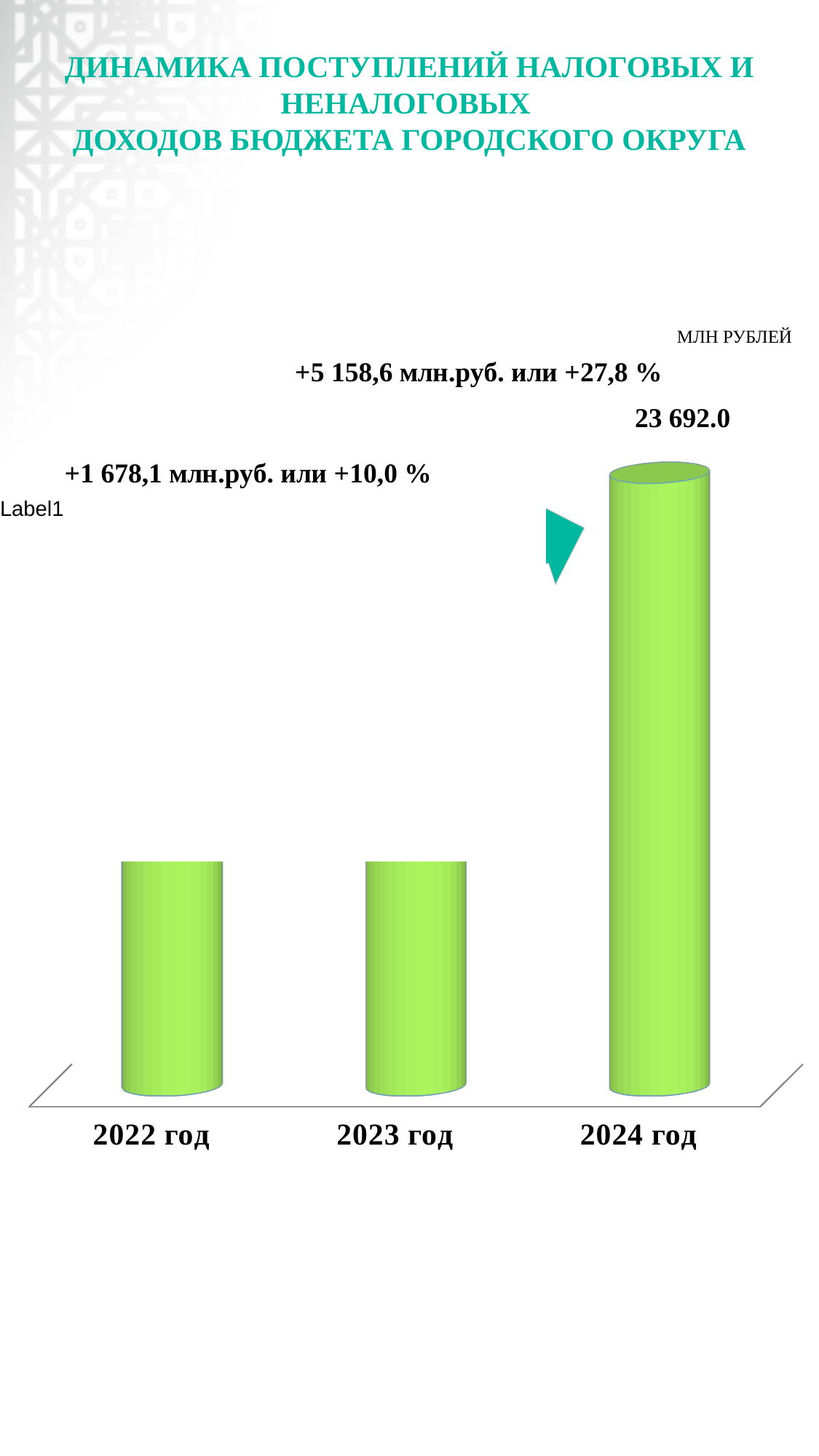
Which is larger, the value for 2024 год or the value for 2022 год? 2024 год Which is larger, the value for 2023 год or the value for 2024 год? 2024 год Do the values rise or fall from 2022 год to 2024 год? rise What unit of measurement is indicated for the chart? МЛН РУБЛЕЙ What increase is annotated above the 2024 год bar? +5 158,6 млн.руб. или +27,8 % How many years are shown on the x axis? 3 Which year has the highest bar? 2024 год What is the value shown for 2024 год? 23 692.0 What kind of chart is shown on the slide? bar chart